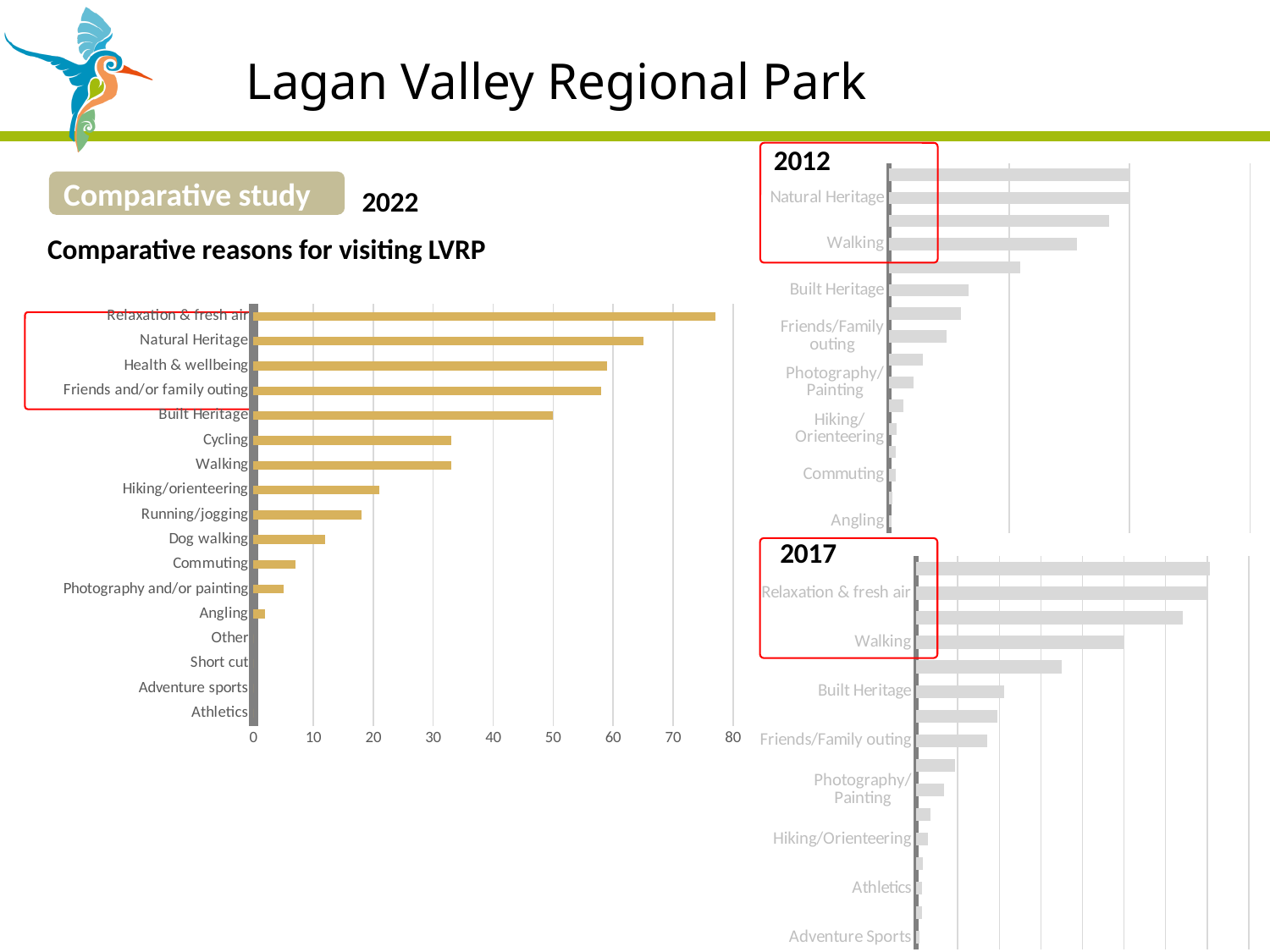
Which three years are compared across the charts on the slide? 2012, 2017 and 2022 In the 2022 chart, which category has the highest value? Relaxation & fresh air In the 2022 chart, which is larger, the value for Built Heritage or the value for Running/jogging? Built Heritage In the 2022 chart, is the value for Health & wellbeing greater or less than 50? greater In the 2022 chart, is the value for Relaxation & fresh air greater or less than 70? greater In the 2022 chart, is the value for Dog walking greater or less than 20? less How many categories are listed on the 2022 chart? 17 What kind of chart is the 2022 chart on the left of the slide? bar chart In the 2022 chart, which is larger, the value for Relaxation & fresh air or the value for Natural Heritage? Relaxation & fresh air